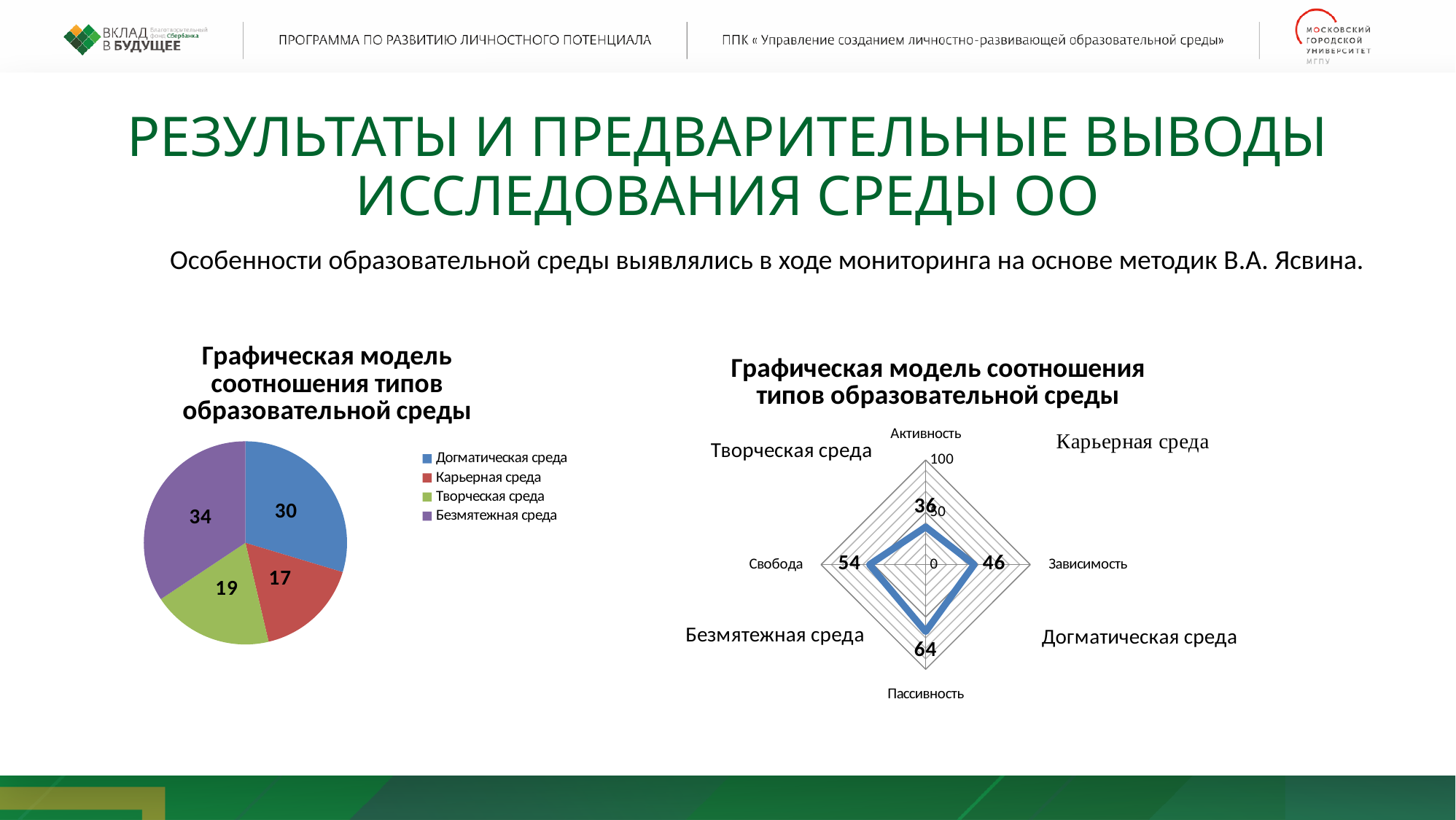
What kind of chart is the chart on the right of the slide? radar chart In the radar chart on the right, what is the value for Свобода? 54 What kind of chart is the chart on the left of the slide? pie chart In the radar chart on the right, which axis has the lowest value? Активность In the radar chart on the right, what is the value for Пассивность? 64 In the pie chart on the left, what is the difference between the values for Безмятежная среда and Творческая среда? 15 In the pie chart on the left, which category has the smallest slice? Карьерная среда In the radar chart on the right, which is larger: the value for Зависимость or the value for Свобода? Свобода How many categories does the legend of the pie chart on the left list? 4 In the pie chart on the left, what is the value for Догматическая среда? 30 In the pie chart on the left, which category has the largest slice? Безмятежная среда In the pie chart on the left, what is the value for Карьерная среда? 17